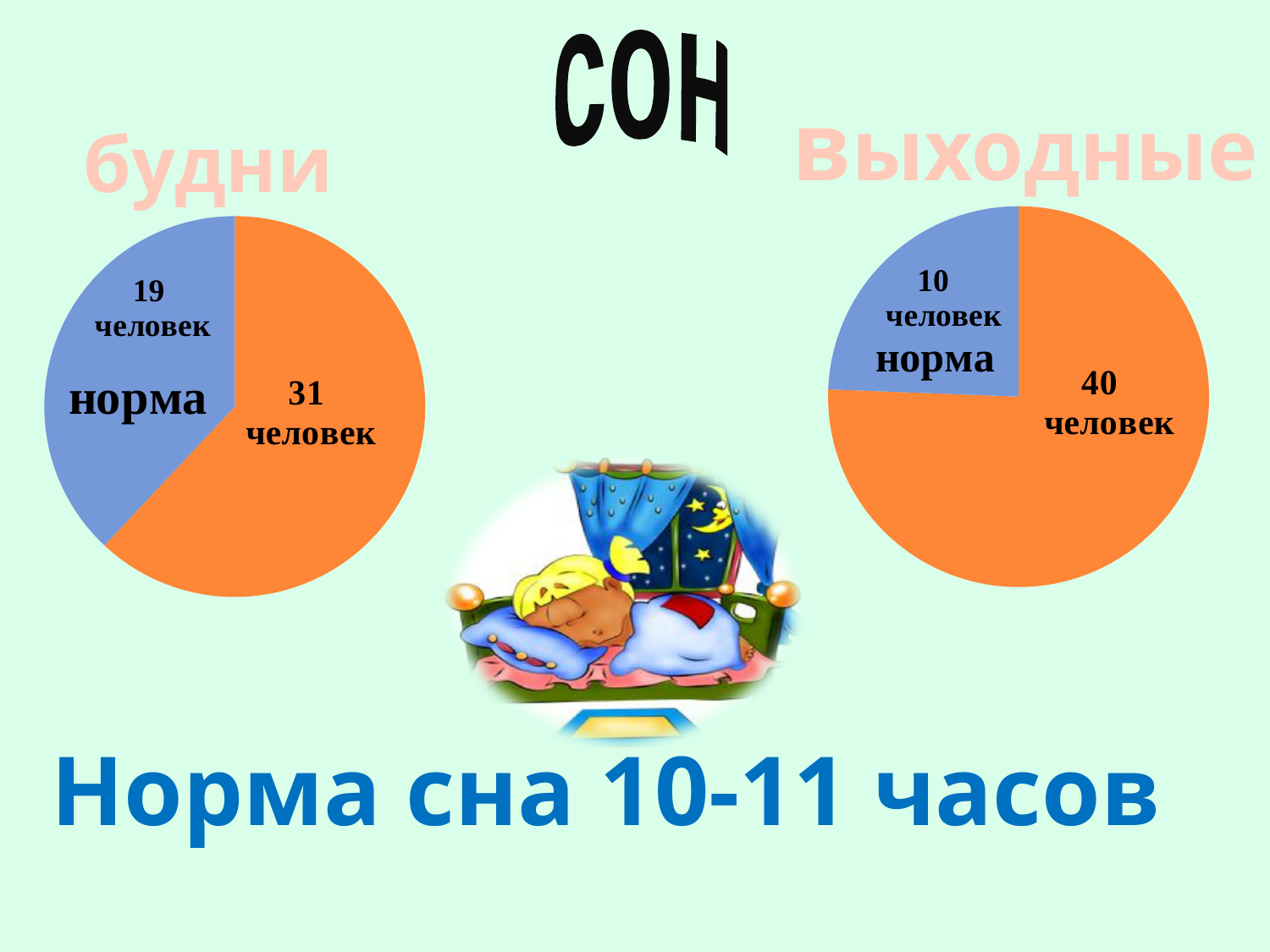
How many slices does the "выходные" pie chart have? 2 In the "выходные" pie chart, how many people are in the "норма" slice? 10 человек In the "будни" pie chart, how many people are in the "норма" slice? 19 человек In the "будни" pie chart, which slice is larger: the "норма" slice or the orange slice? the orange slice (31 человек) What share of the "выходные" pie chart does the "норма" slice represent? 20% What colour is the "норма" slice in both pie charts? blue What is the difference between the two slices in the "выходные" pie chart? 30 человек In the "выходные" pie chart, how many people are in the orange slice? 40 человек In the "будни" pie chart, how many people are in the orange slice? 31 человек In the "выходные" pie chart, which slice is the smallest? норма (10 человек) What kind of chart is used for the "будни" data? pie chart What is the difference between the two slices in the "будни" pie chart? 12 человек